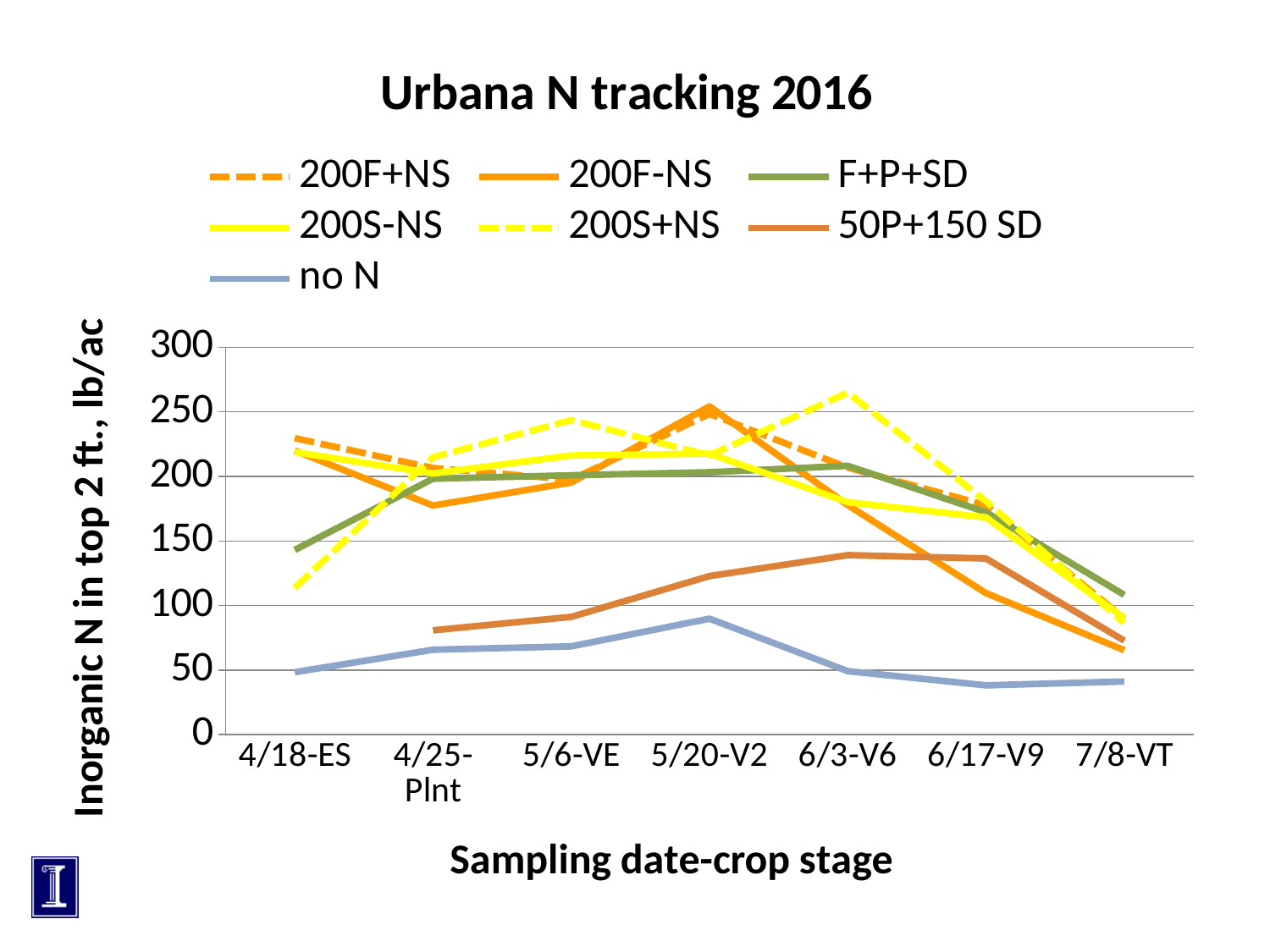
How many sampling date-crop stage categories are on the x axis? 7 At 4/18-ES, which is larger: 200S+NS or F+P+SD? F+P+SD Is the value for no N at 5/20-V2 greater or less than 100? less Is the value for 200S+NS at 6/3-V6 greater or less than 250? greater What kind of chart is shown on the slide? line chart How many series does the legend list? 7 What is the title of the y axis? Inorganic N in top 2 ft., lb/ac Is the value for 50P+150 SD at 6/3-V6 greater or less than 150? less Which series has the highest value at 6/3-V6? 200S+NS Does the no N series rise or fall from 5/20-V2 to 6/17-V9? fall Which series has the lowest value at 4/18-ES? no N Which series has the lowest value at 7/8-VT? no N